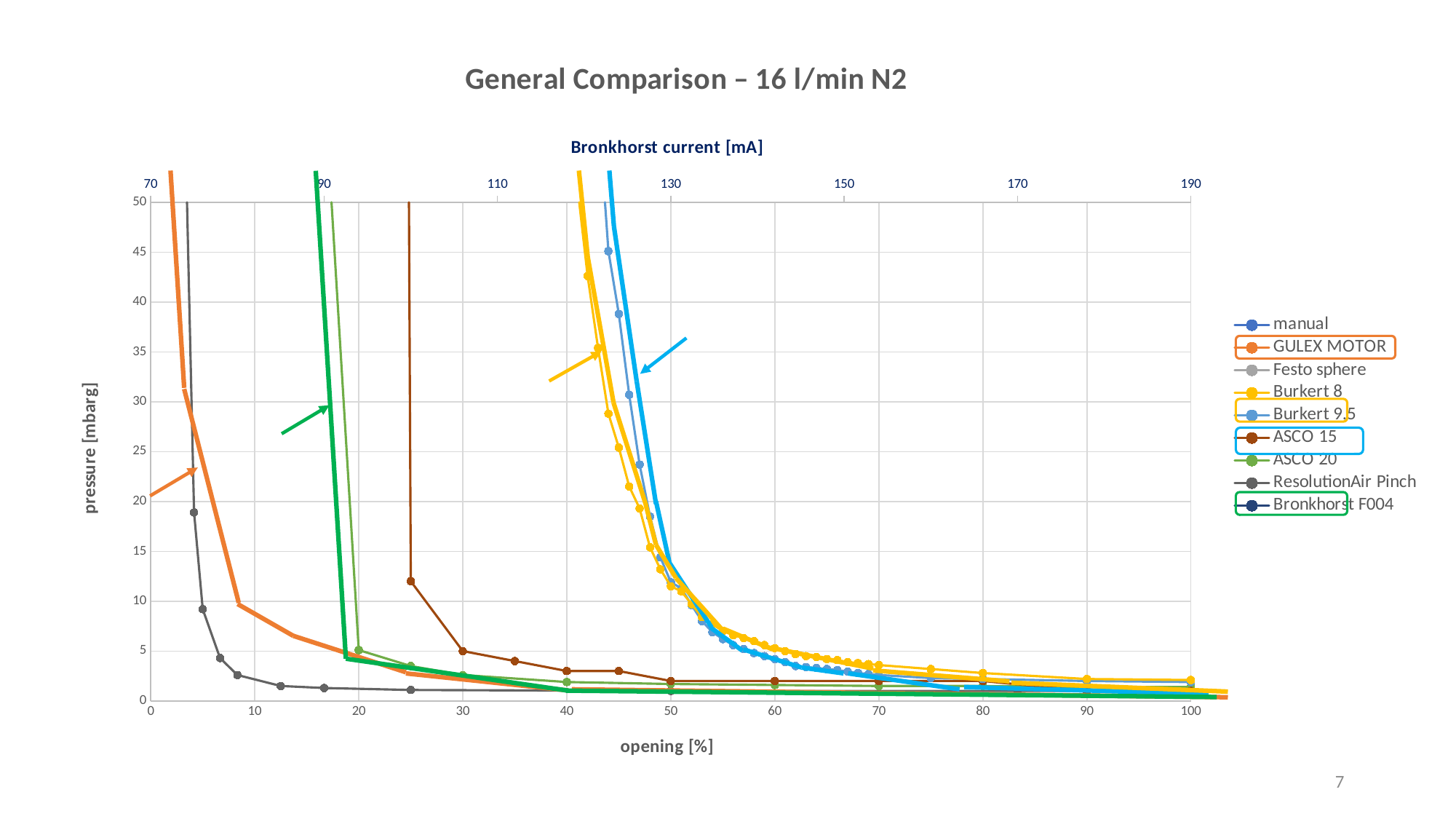
What kind of chart is shown on the slide? line chart As opening [%] increases, does the pressure for the ASCO 15 series rise or fall? fall As opening [%] increases, does the pressure for the GULEX MOTOR series rise or fall? fall At 30% opening, which series has the higher pressure: ASCO 15 or ResolutionAir Pinch? ASCO 15 What is the label of the vertical axis? pressure [mbarg] At 25% opening, which series has the higher pressure: ASCO 15 or GULEX MOTOR? ASCO 15 What is the title of the chart? General Comparison – 16 l/min N2 How many series does the legend list? 9 Is the GULEX MOTOR pressure at 30% opening greater or less than 5? less Is the ASCO 15 pressure at 25% opening greater or less than 10? greater Is the ASCO 15 pressure at 30% opening greater or less than 10? less